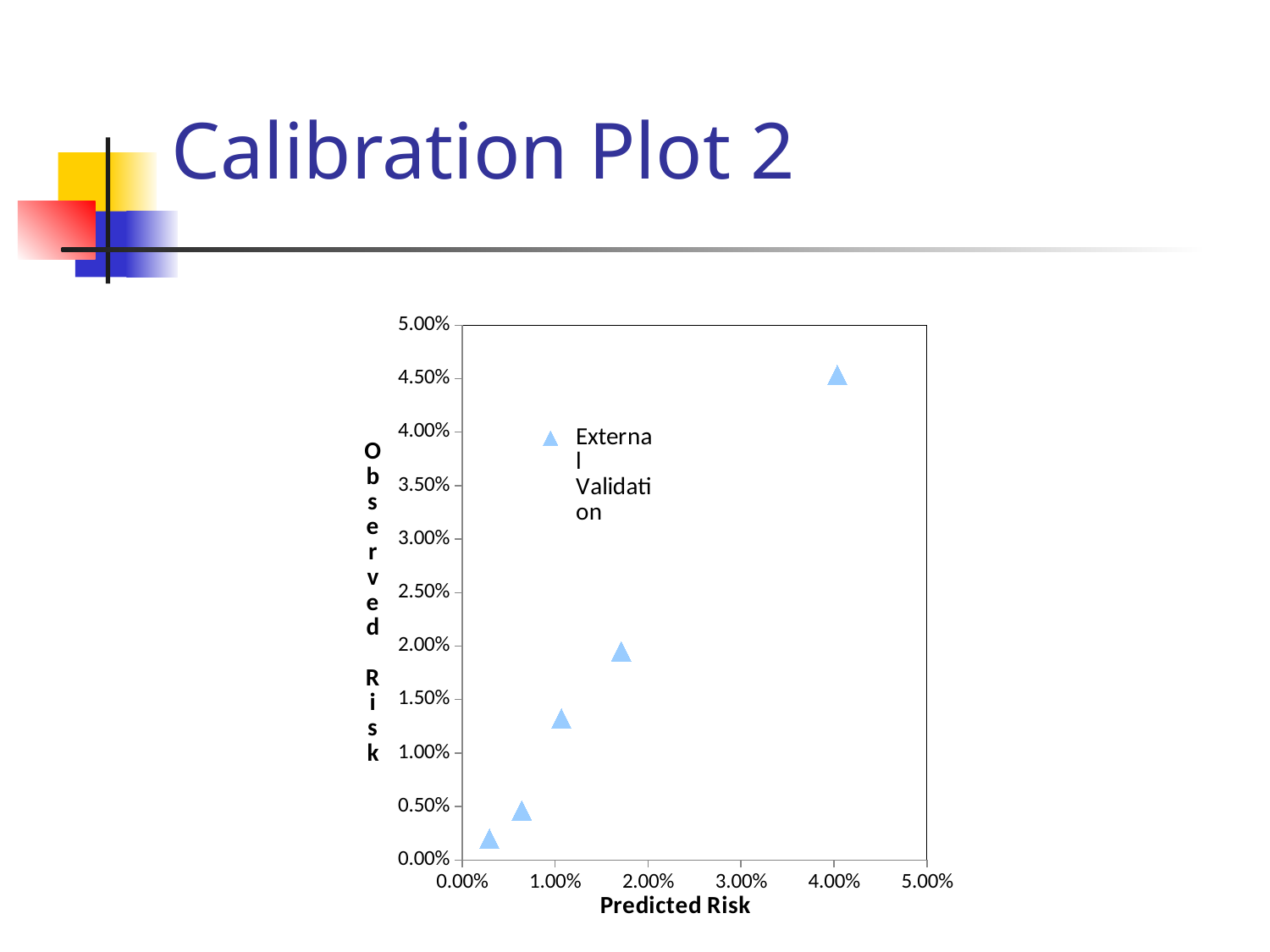
Is the predicted risk of the rightmost point greater or less than 3.00%? greater What kind of chart is shown on the slide? scatter plot How many series does the legend list? 1 Do the observed risk values rise or fall as predicted risk increases along the x axis? rise Which has the higher observed risk: the point with the highest predicted risk or the point with the lowest predicted risk? the point with the highest predicted risk What is the name of the series shown in the legend? External Validation Is the observed risk of the point with the second-highest predicted risk greater or less than 1.50%? greater Is the observed risk of the point with the highest predicted risk greater or less than 4.00%? greater What is the title of the x axis? Predicted Risk How many data points are plotted in the chart? 5 How many points have a predicted risk greater than 2.00%? 1